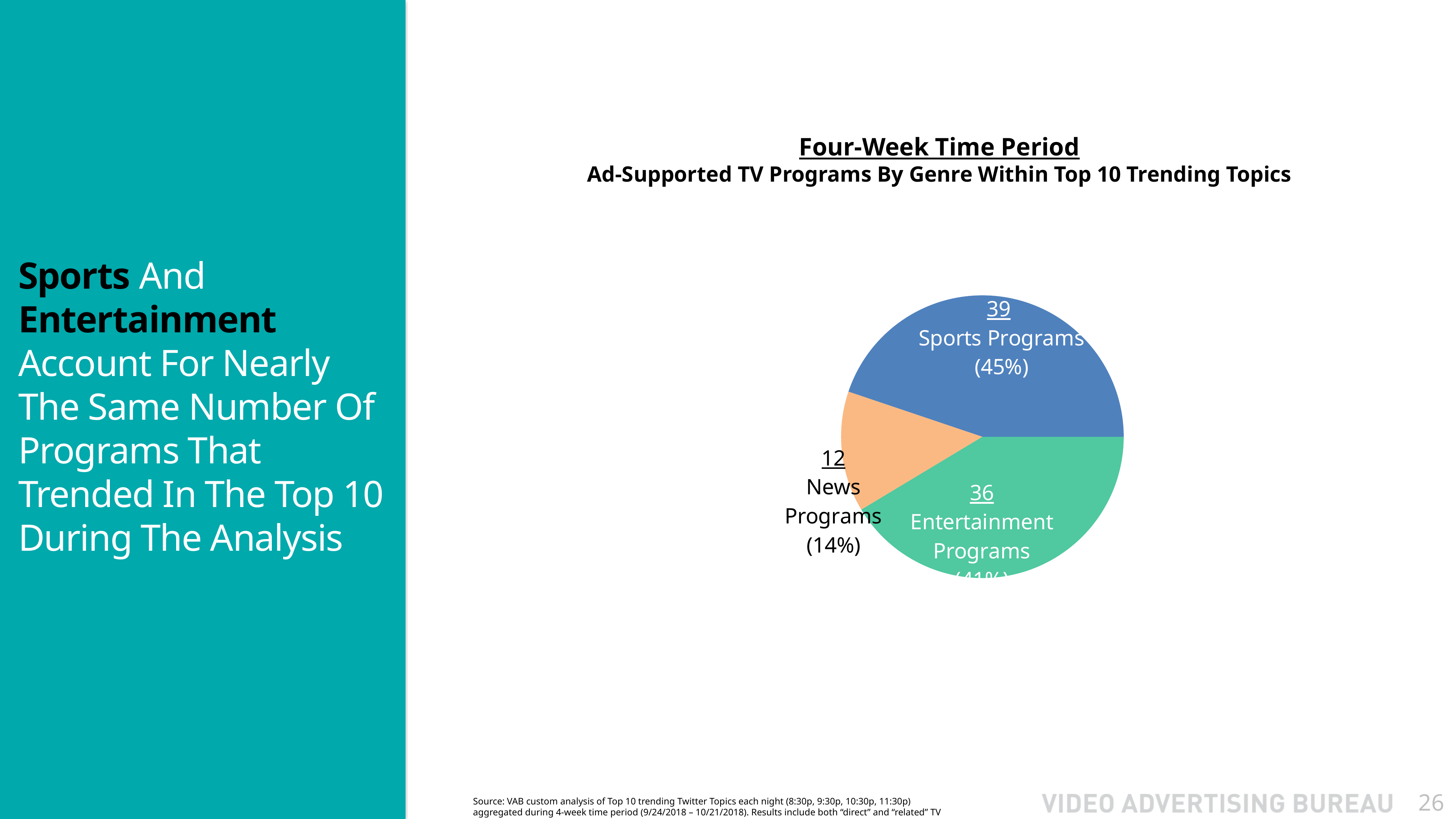
How many Entertainment Programs are shown in the pie chart? 36 Which genre has the largest slice of the pie chart? Sports Programs What is the difference between the number of Sports Programs and Entertainment Programs? 3 What kind of chart is shown on the slide? Pie chart What share of the pie do News Programs account for? 14% How many News Programs are shown in the pie chart? 12 What share of the pie do Sports Programs account for? 45% Which genre has the smallest slice of the pie chart? News Programs How many slices does the pie chart have? 3 What is the title of the chart? Four-Week Time Period Ad-Supported TV Programs By Genre Within Top 10 Trending Topics How many Sports Programs are shown in the pie chart? 39 Which is larger, the number of Entertainment Programs or the number of News Programs? Entertainment Programs